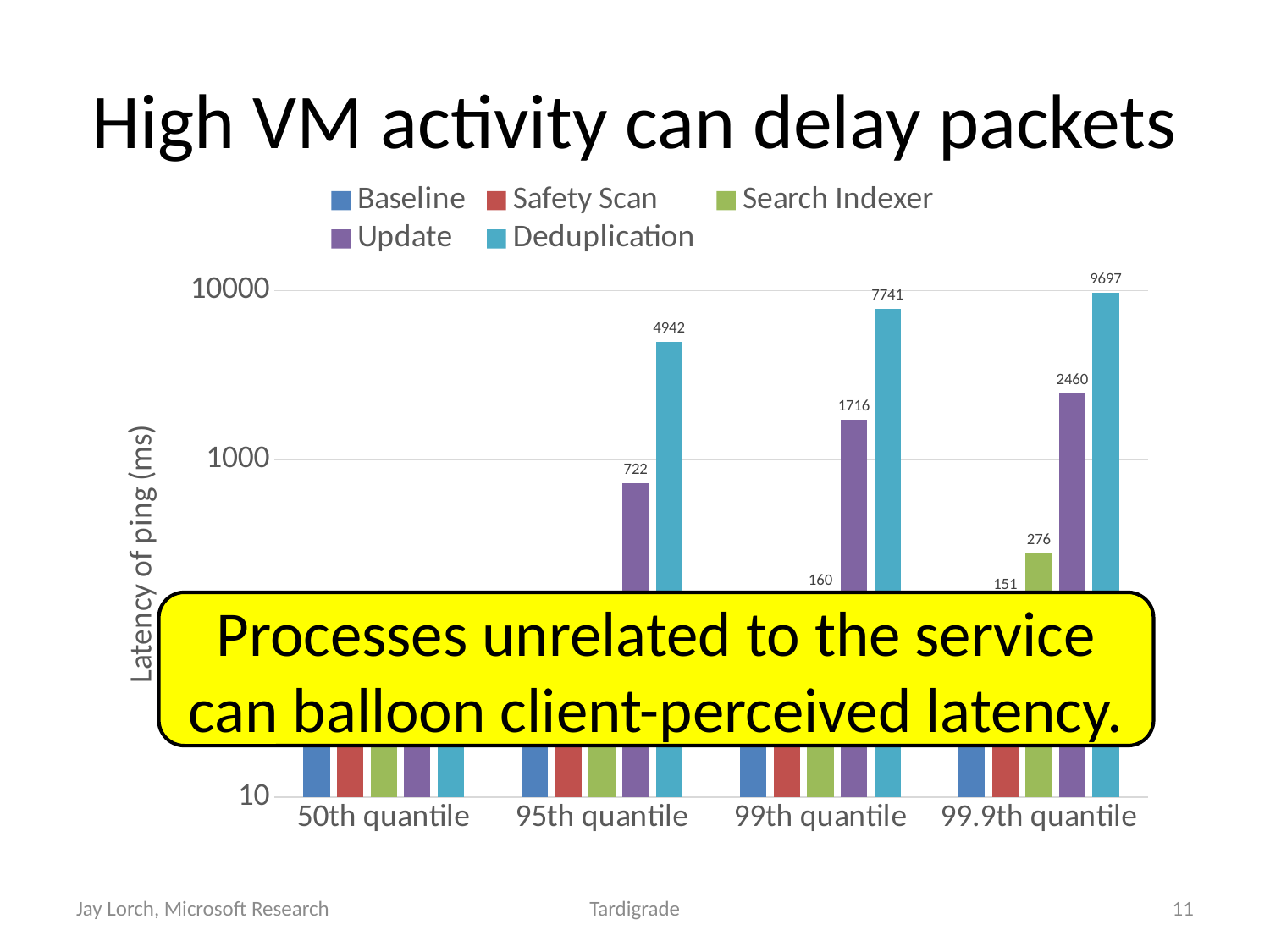
What is the difference between the Deduplication values at the 99.9th and 99th quantiles? 1956 What is the Deduplication value at the 99th quantile? 7741 What is the difference between the Deduplication and Update values at the 95th quantile? 4220 How many series does the legend list? 5 What is the Update value at the 95th quantile? 722 Is the Update value at the 95th quantile greater or less than 1000? less How many quantile categories are shown on the x axis? 4 Which is larger at the 99th quantile, Update or Deduplication? Deduplication What is the Deduplication value at the 99.9th quantile? 9697 What is the Search Indexer value at the 99.9th quantile? 276 Do the Deduplication values rise or fall from the 95th quantile to the 99.9th quantile? rise Which series has the highest value at the 99.9th quantile? Deduplication